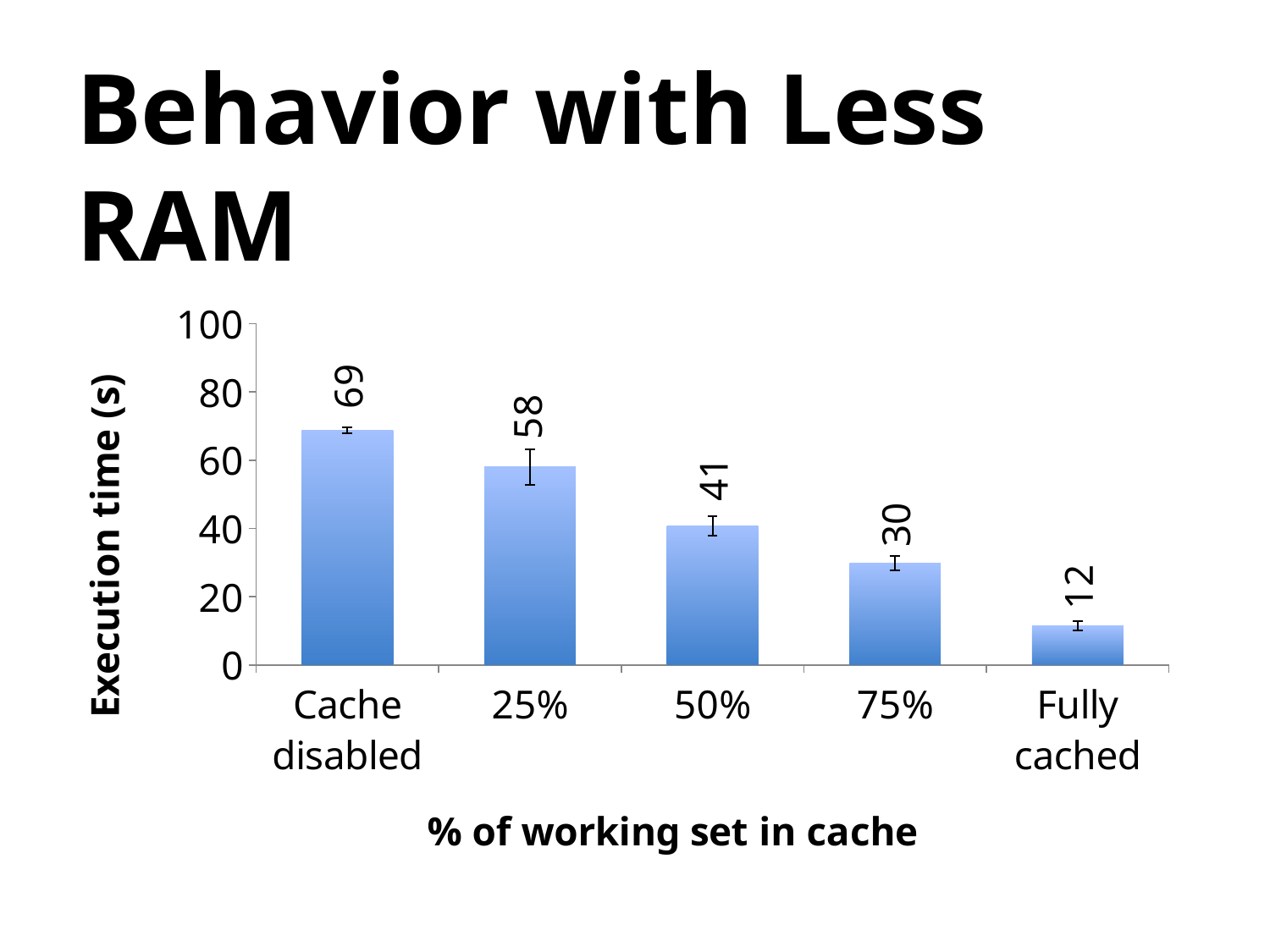
What kind of chart is shown on the slide? Bar chart Is the execution time for 75% of the working set in cache greater or less than 40? less What is the execution time when the cache is disabled? 69 Which category has the highest execution time? Cache disabled Do the execution times rise or fall as the percentage of the working set in cache increases along the x axis? Fall What is the difference in execution time between 25% and 75% of the working set in cache? 28 Which category has the lowest execution time? Fully cached What is the label of the y axis? Execution time (s) How many categories are shown on the x axis? 5 What is the execution time when 50% of the working set is in cache? 41 Which has a larger execution time, 50% or 75% of the working set in cache? 50% What is the execution time when the working set is fully cached? 12